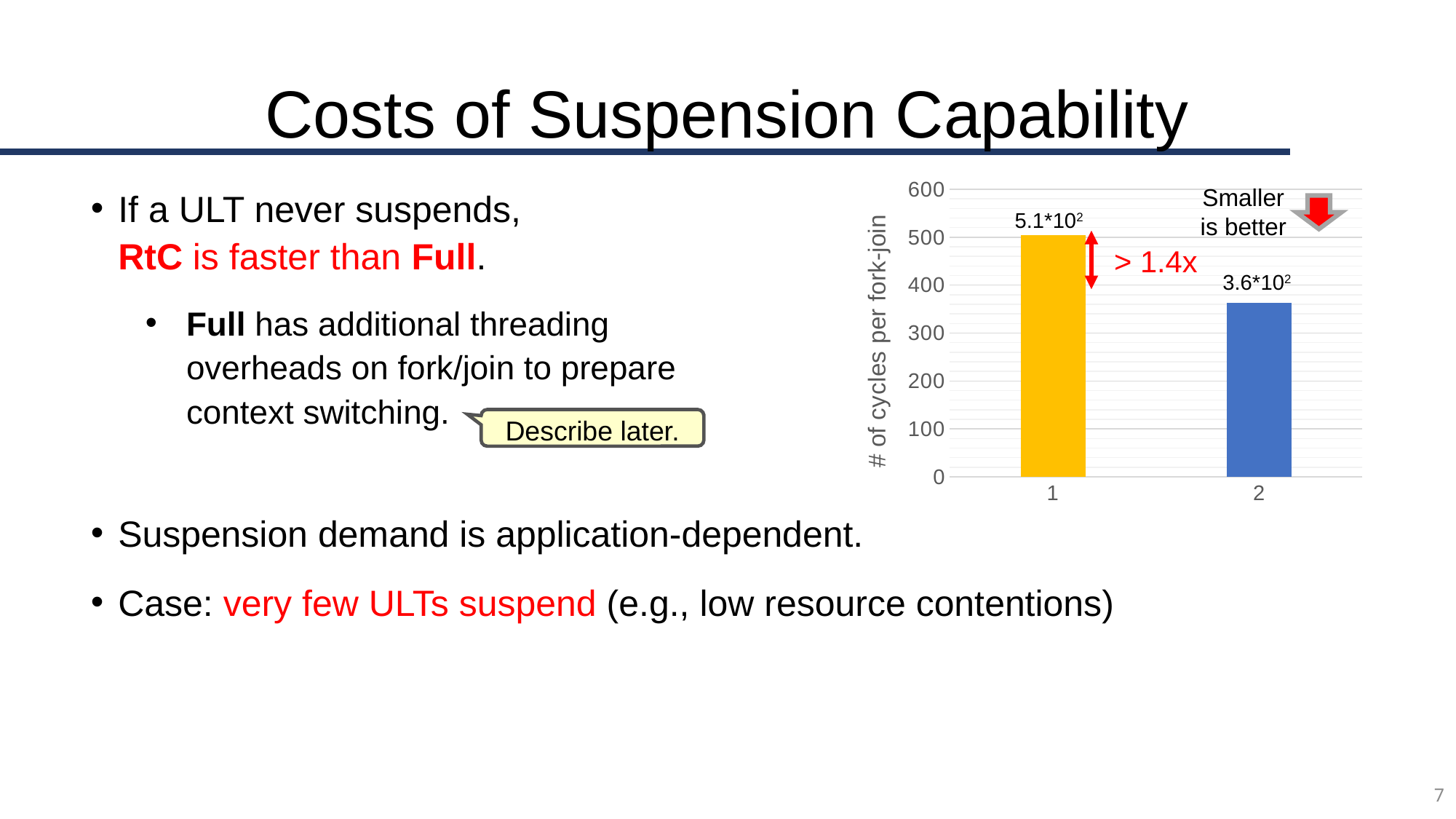
What is the label of the y axis of the chart? # of cycles per fork-join Which bar is larger, bar 1 or bar 2? 1 What is the value of bar 1 in the chart? 5.1*10² How many bars are plotted in the chart? 2 Is the value for bar 2 greater or less than 400? less Which bar has the highest value in the chart? 1 What is the maximum value shown on the y axis of the chart? 600 Which bar has the lowest value in the chart? 2 What kind of chart is shown on the slide? bar chart Is the value for bar 2 greater or less than 300? greater What is the value of bar 2 in the chart? 3.6*10² Is the value for bar 1 greater or less than 400? greater